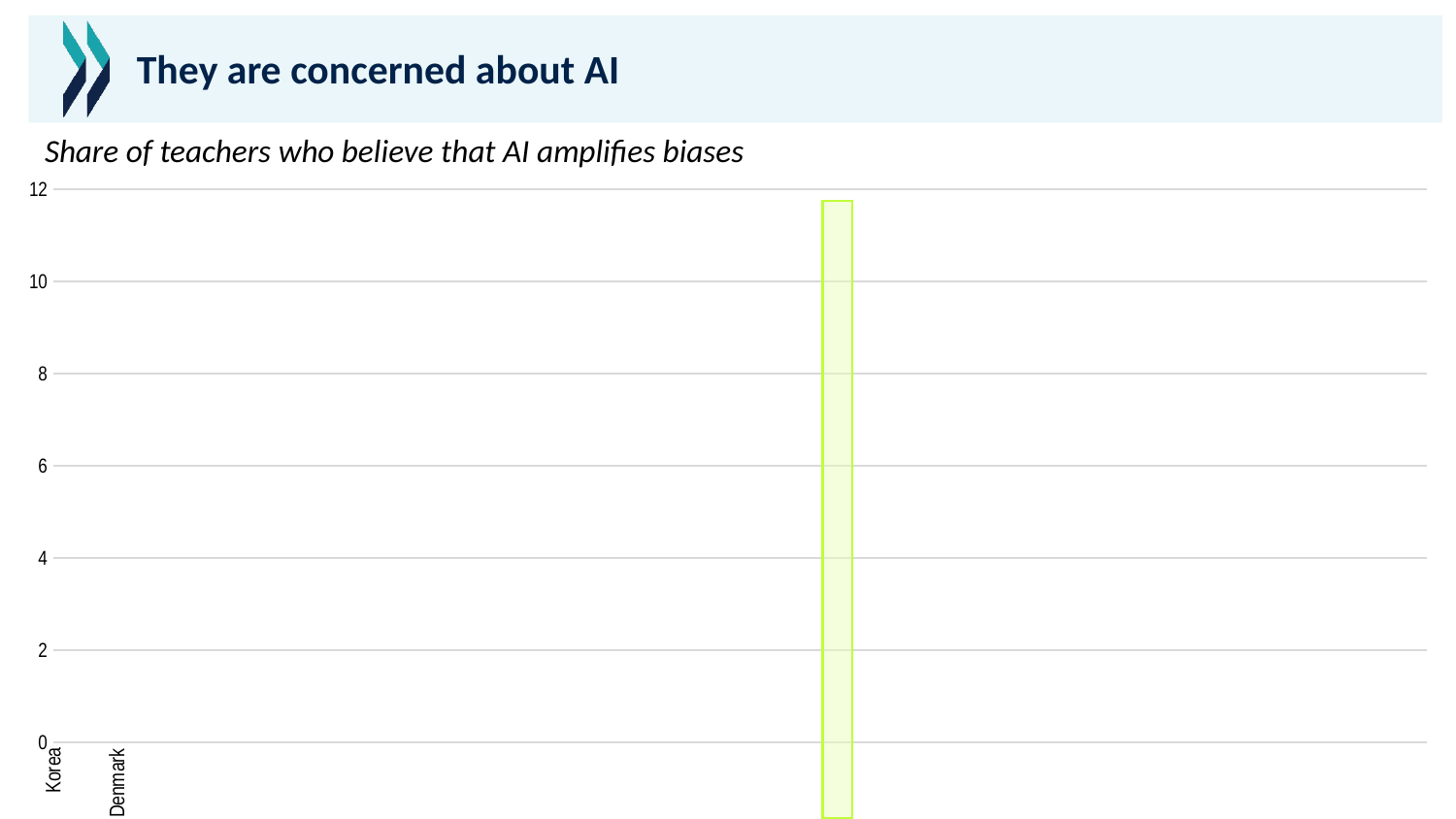
Is the value of the single plotted bar greater or less than 10? greater What is the title of the chart? Share of teachers who believe that AI amplifies biases What kind of chart is shown on the slide? bar chart What is the highest value shown on the vertical axis? 12 Is the value of the single plotted bar greater or less than 8? greater How many bars are plotted on the chart? 1